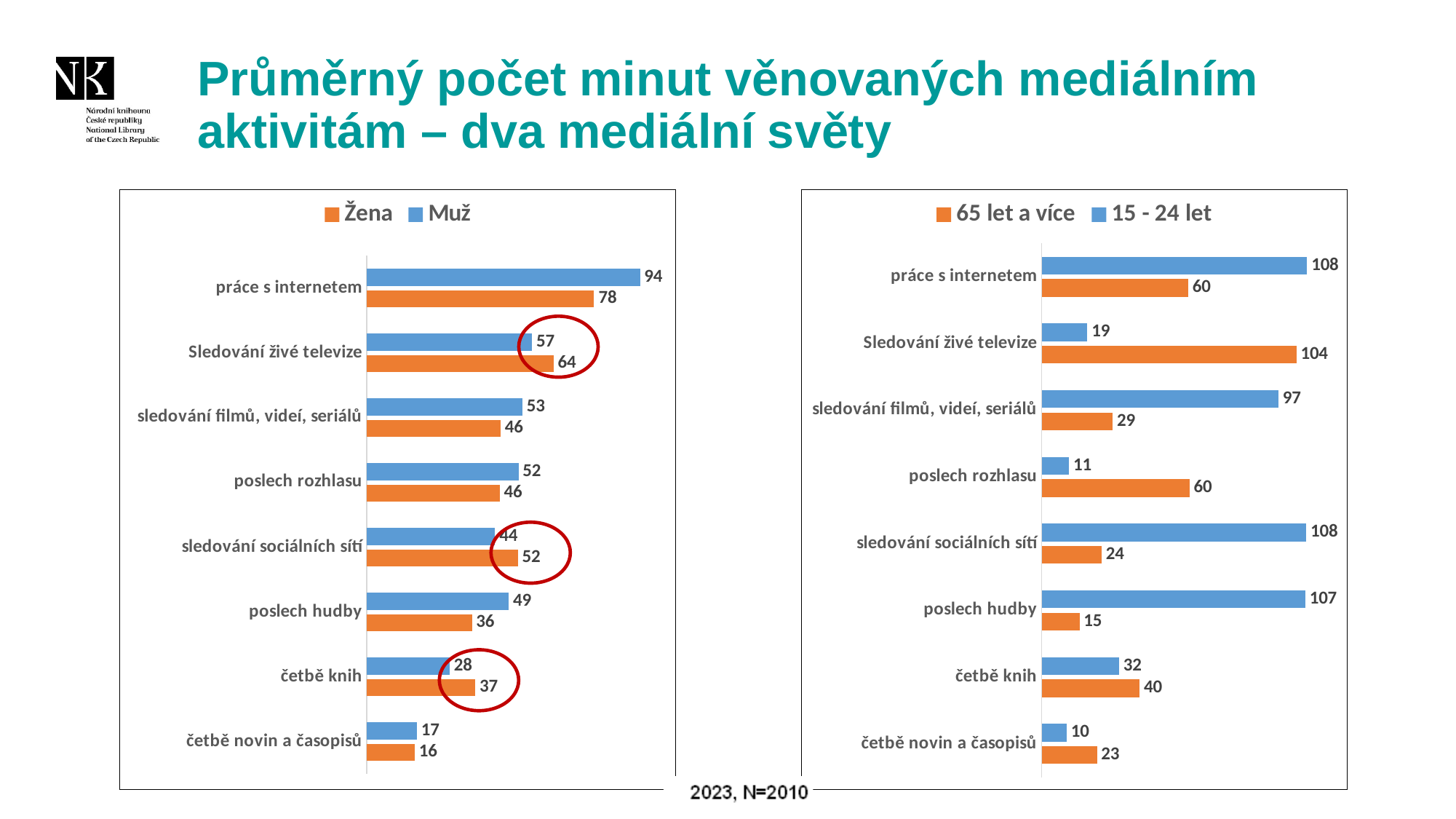
In the right chart (65 let a více / 15 - 24 let), what is the value for 65 let a více for Sledování živé televize? 104 In the left chart (Žena / Muž), what is the value for Muž for práce s internetem? 94 In the right chart (65 let a více / 15 - 24 let), which category has the lowest value for 15 - 24 let? četbě novin a časopisů In the left chart (Žena / Muž), which category has the lowest value for Žena? četbě novin a časopisů In the left chart (Žena / Muž), what is the value for Žena for Sledování živé televize? 64 How many categories are shown in the left chart (Žena / Muž)? 8 In the right chart (65 let a více / 15 - 24 let), what is the difference between 15 - 24 let and 65 let a více for sledování sociálních sítí? 84 In the left chart (Žena / Muž), what is the difference between Žena and Muž for četbě knih? 9 In the right chart (65 let a více / 15 - 24 let), what is the value for 15 - 24 let for poslech hudby? 107 What type of chart is the left chart (Žena / Muž)? bar chart In the right chart (65 let a více / 15 - 24 let), which is larger for poslech rozhlasu: 65 let a více or 15 - 24 let? 65 let a více How many series does the legend of the right chart list? 2